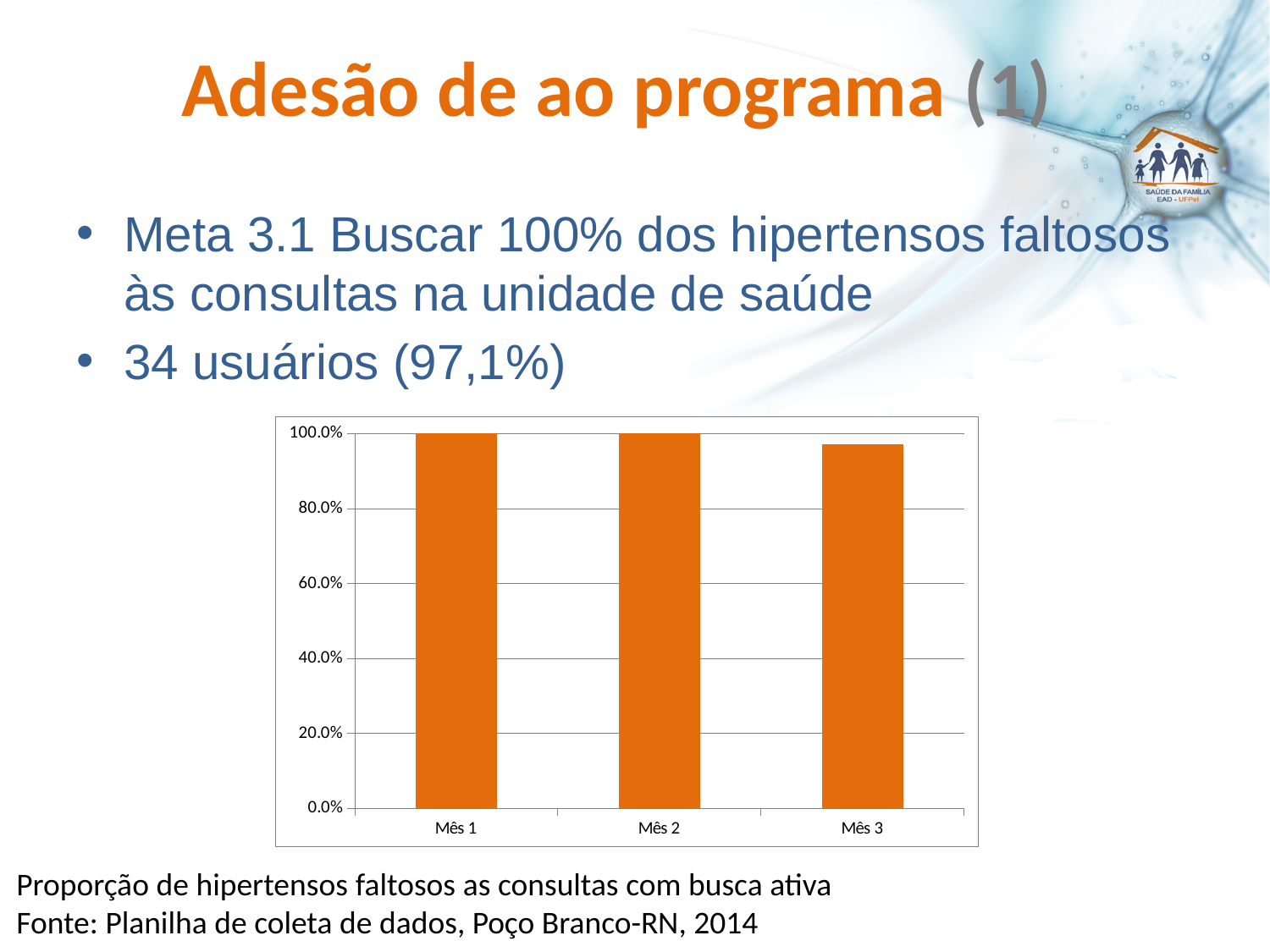
Which month has the lowest value? Mês 3 What is the value for Mês 2? 100.0% Is the value for Mês 3 greater or less than 80.0%? greater What is the value for Mês 1? 100.0% Which is larger, the value for Mês 1 or the value for Mês 3? Mês 1 How many months are shown on the x axis? 3 What is the highest value shown on the y axis? 100.0% What kind of chart is shown on the slide? bar chart What colour are the bars in the chart? orange Is the value for Mês 1 greater or less than 60.0%? greater